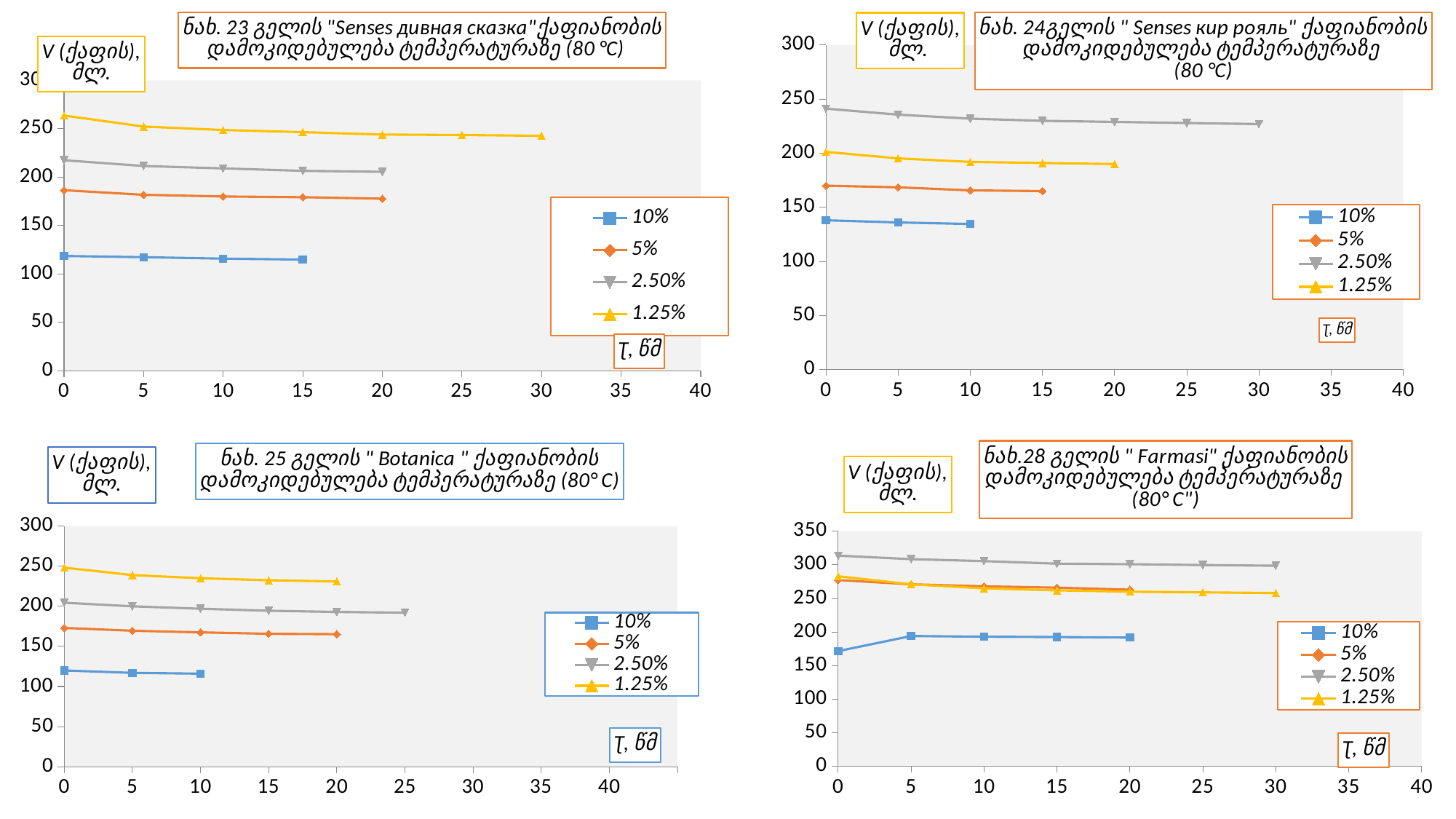
In the bottom-left chart (ნახ. 25, Botanica), which series is higher at 0 minutes: 1.25% or 2.50%? 1.25% In the top-right chart (ნახ. 24, Senses кир рояль), is the value of the 2.50% series at 0 minutes greater or less than 250? less How many data points does the 10% series have in the top-right chart (ნახ. 24, Senses кир рояль)? 3 In the bottom-right chart (ნახ. 28, Farmasi), is the value of the 2.50% series at 0 minutes greater or less than 300? greater In the top-left chart (ნახ. 23, Senses дивная сказка), does the 1.25% series rise or fall as time increases? fall In the top-left chart (ნახ. 23, Senses дивная сказка), is the value of the 10% series at 0 minutes greater or less than 150? less What kind of chart is the top-left chart (ნახ. 23, Senses дивная сказка)? line chart In the bottom-right chart (ნახ. 28, Farmasi), does the 10% series rise or fall between 0 and 5 minutes? rise How many data points does the 1.25% series have in the top-left chart (ნახ. 23, Senses дивная сказка)? 7 In the bottom-left chart (ნახ. 25, Botanica), which series has the highest values? 1.25% How many series does the legend of the top-right chart (ნახ. 24, Senses кир рояль) list? 4 What colour is used for the 1.25% series in the legend of the bottom-left chart (ნახ. 25, Botanica)? yellow